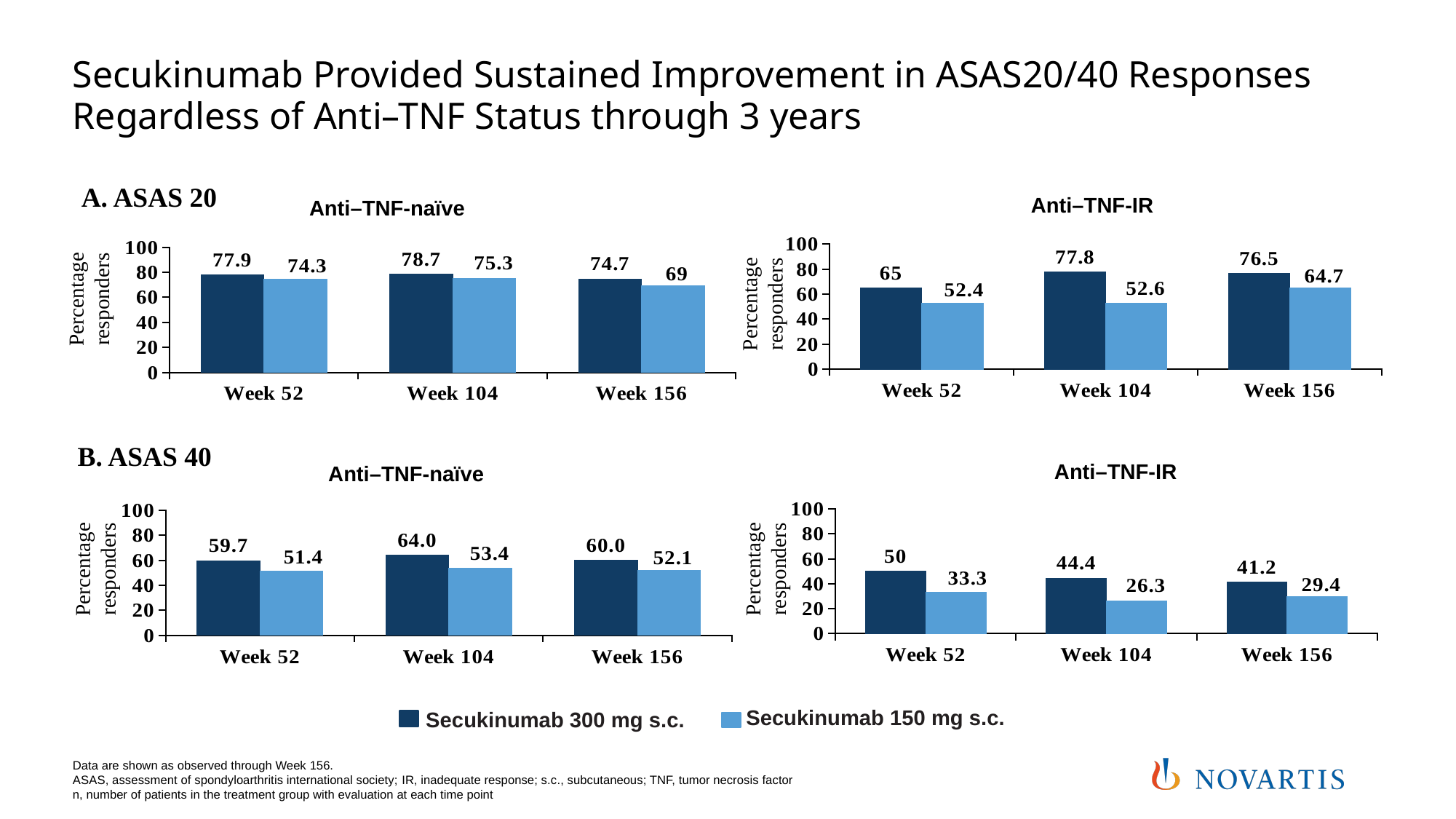
In the ASAS 20 Anti–TNF-IR chart, is the Secukinumab 150 mg s.c. value at Week 156 greater or less than 60? greater How many series does the legend at the bottom of the slide list? 2 In the ASAS 40 Anti–TNF-IR chart, at which week is the Secukinumab 150 mg s.c. value lowest? Week 104 In the ASAS 40 Anti–TNF-IR chart, does the Secukinumab 300 mg s.c. value rise or fall from Week 52 to Week 156? fall What kind of chart is the ASAS 40 Anti–TNF-IR chart? bar chart In the ASAS 20 Anti–TNF-IR chart, what is the value for Secukinumab 150 mg s.c. at Week 52? 52.4 In the ASAS 40 Anti–TNF-IR chart, what is the value for Secukinumab 300 mg s.c. at Week 156? 41.2 How many week time points are shown on the x axis of the ASAS 20 Anti–TNF-naïve chart? 3 In the ASAS 40 Anti–TNF-naïve chart, which is larger at Week 156: Secukinumab 300 mg s.c. or Secukinumab 150 mg s.c.? Secukinumab 300 mg s.c. In the ASAS 40 Anti–TNF-naïve chart, at which week is the Secukinumab 300 mg s.c. value highest? Week 104 In the ASAS 20 Anti–TNF-IR chart, what is the difference between the Secukinumab 300 mg s.c. and Secukinumab 150 mg s.c. values at Week 104? 25.2 In the ASAS 20 Anti–TNF-naïve chart, what is the value for Secukinumab 300 mg s.c. at Week 104? 78.7